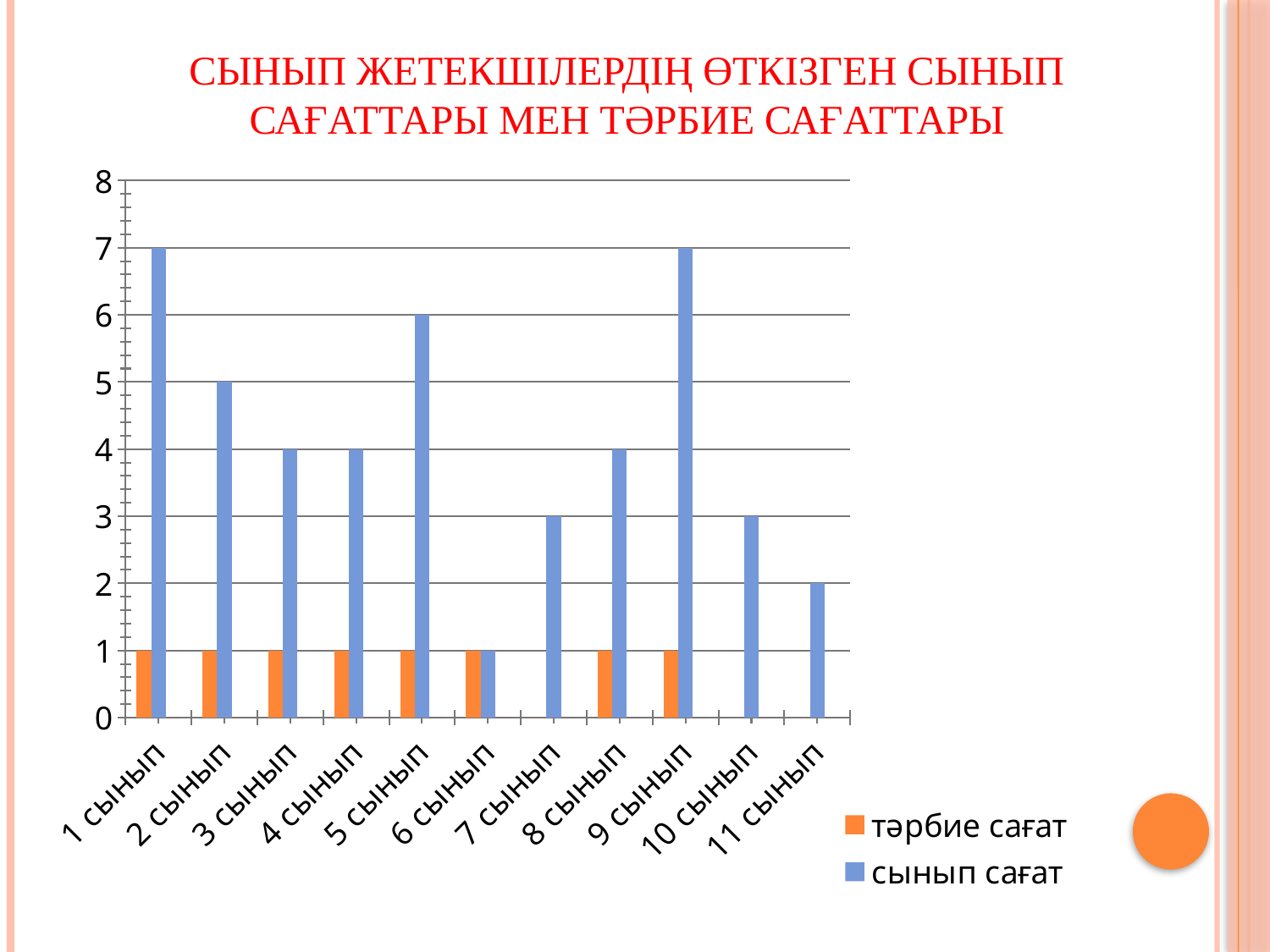
Which series is shown in orange in the legend? тәрбие сағат Which is larger, the сынып сағат value for 2 сынып or for 7 сынып? 2 сынып Is the value of сынып сағат for 9 сынып greater or less than 4? greater What type of chart is shown on the slide? bar chart What is the value of тәрбие сағат for 3 сынып? 1 What is the value of сынып сағат for 5 сынып? 6 What is the difference between the сынып сағат values for 1 сынып and 11 сынып? 5 What is the value of сынып сағат for 1 сынып? 7 What is the value of сынып сағат for 11 сынып? 2 How many categories (classes) are shown on the x axis? 11 How many series does the legend list? 2 Which class has the lowest value of сынып сағат? 6 сынып